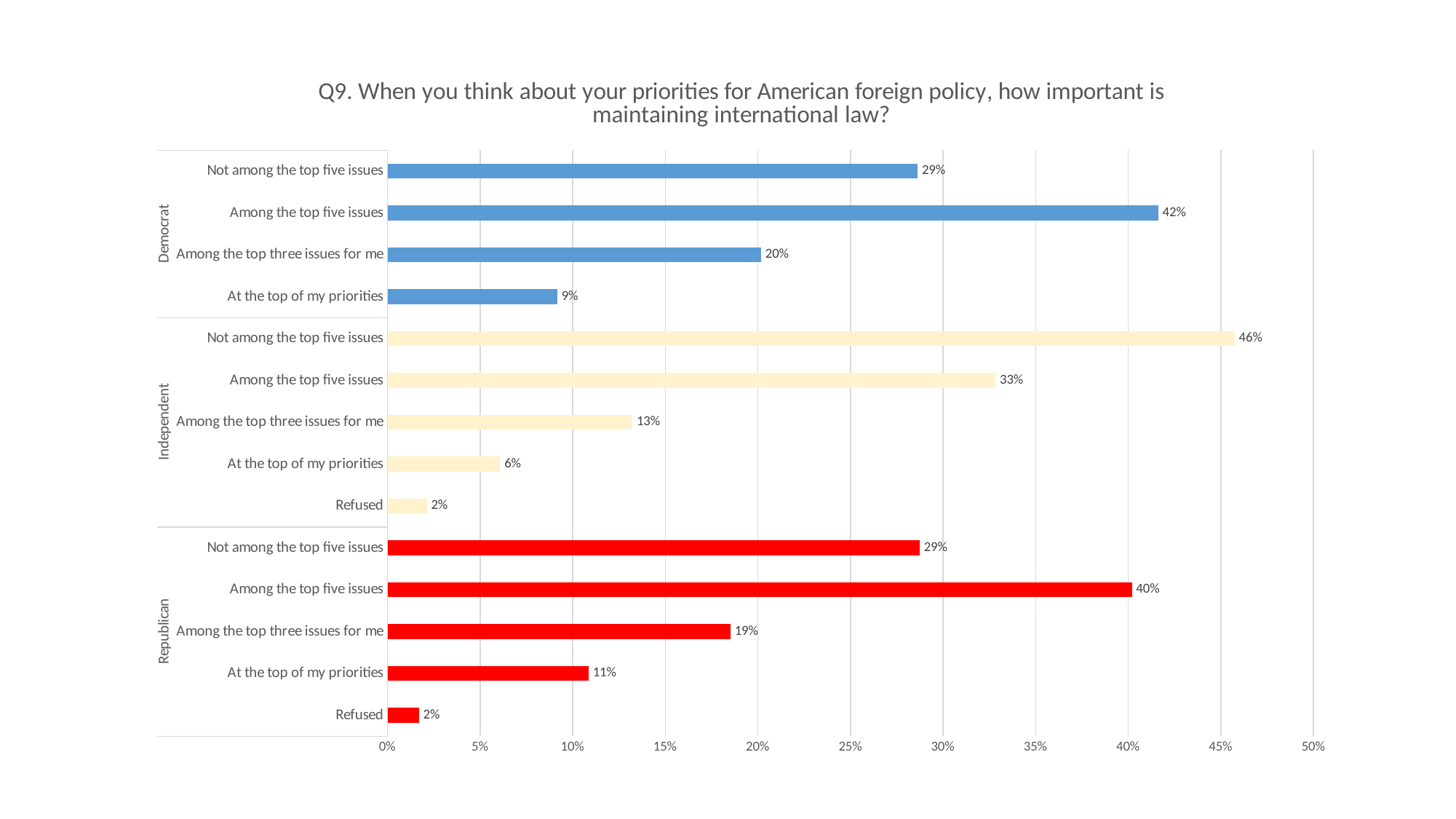
Which is larger: the Democrat or the Republican percentage for 'Among the top five issues'? Democrat Which response has the lowest percentage among Democrats? At the top of my priorities What percentage of Democrats said maintaining international law is among the top five issues? 42% What percentage of Republicans said maintaining international law is at the top of their priorities? 11% Which response has the highest percentage among Republicans? Among the top five issues How many bars are plotted for the Republican group? 5 Is the Independent value for 'Among the top five issues' greater or less than 30%? greater What percentage of Independents said maintaining international law is not among the top five issues? 46% What is the total of the Independent percentages for 'At the top of my priorities' and 'Refused'? 8% What type of chart is shown on the slide? Bar chart What is the difference between the Democrat and Independent percentages for 'Among the top three issues for me'? 7% What colour are the bars for the Independent group? Light yellow